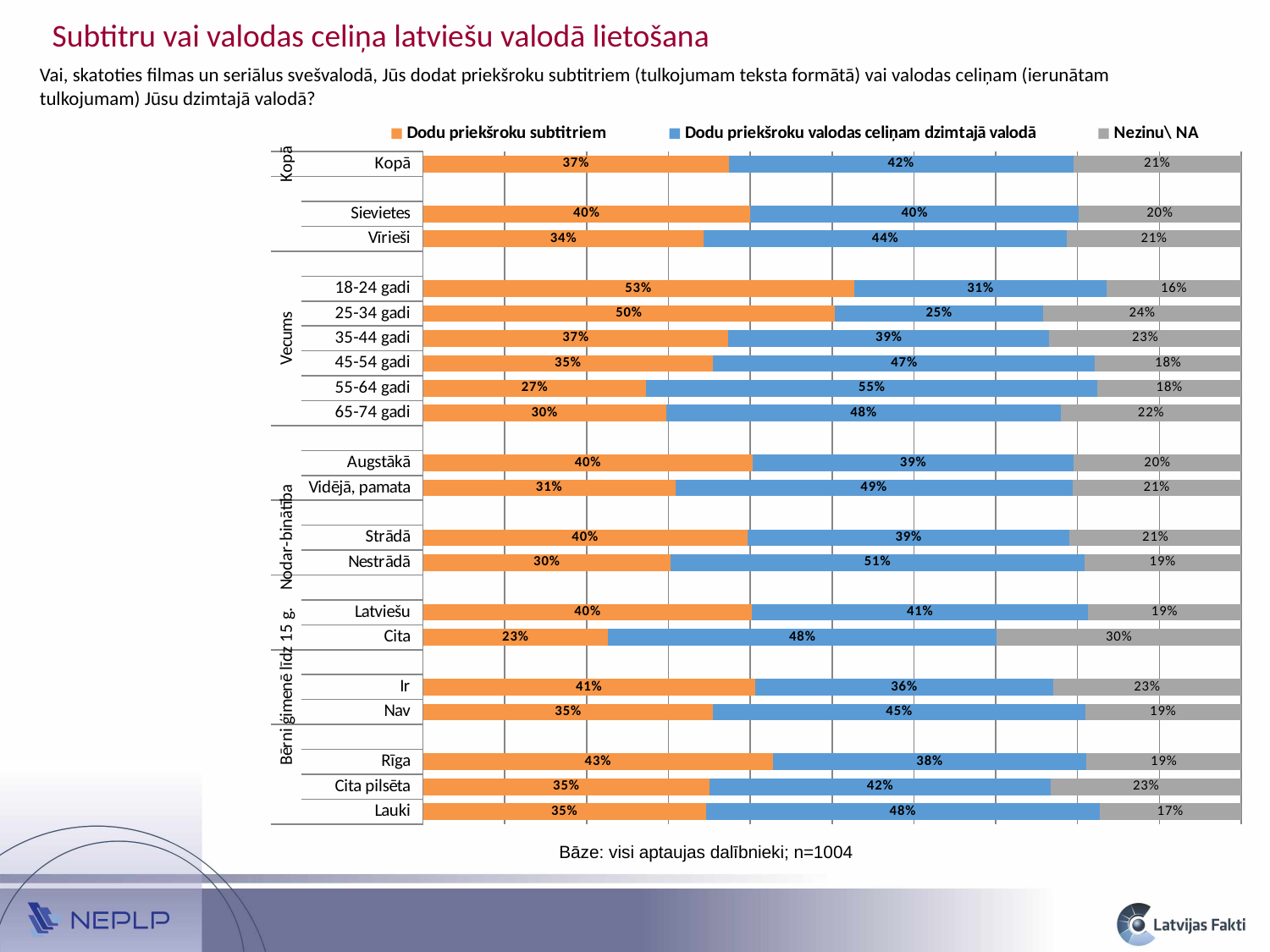
What kind of chart is shown on the slide? Stacked bar chart Which category has the lowest "Nezinu\ NA" value? 18-24 gadi Which category has the lowest value for "Dodu priekšroku subtitriem"? Cita Which is larger: the "Dodu priekšroku subtitriem" value for Rīga or for Lauki? Rīga How many series does the legend list? 3 Which category has the highest value for "Dodu priekšroku subtitriem"? 18-24 gadi What is the value of "Dodu priekšroku valodas celiņam dzimtajā valodā" for 55-64 gadi? 55% Which category has the highest value for "Dodu priekšroku valodas celiņam dzimtajā valodā"? 55-64 gadi What is the value of "Dodu priekšroku subtitriem" for Kopā? 37% What is the difference between the "Dodu priekšroku subtitriem" values for 18-24 gadi and 65-74 gadi? 23% What is the "Nezinu\ NA" value for Cita? 30% What is the total of the three segments for the Sievietes bar? 100%